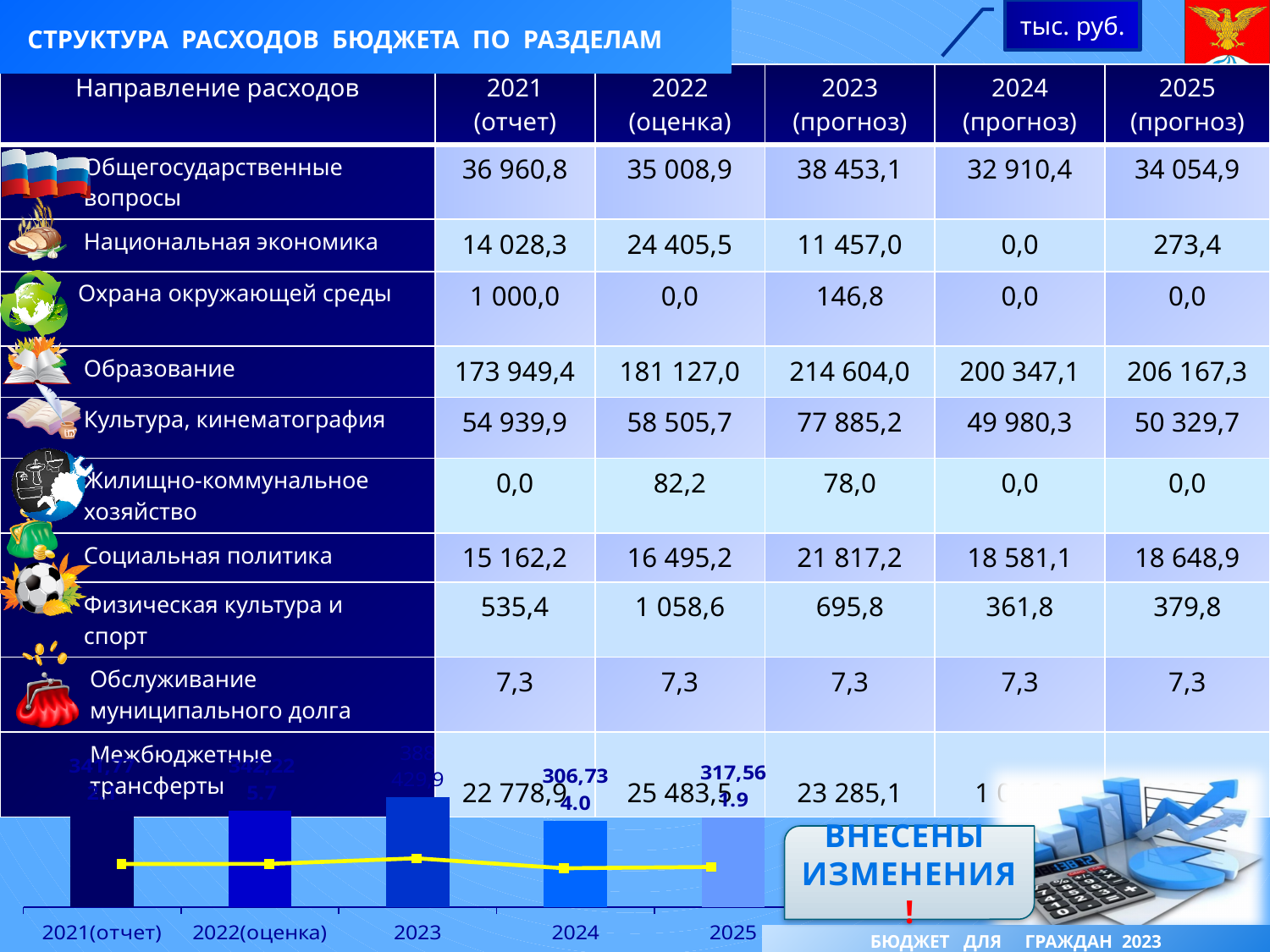
How many categories are shown on the x axis of the chart at the bottom of the slide? 5 In the chart at the bottom of the slide, what is the difference between the bar values for 2025 and 2024? 10,827.9 What is the label of the second category on the x axis of the chart at the bottom of the slide? 2022(оценка) In the chart at the bottom of the slide, do the bar values rise or fall from 2024 to 2025? rise In the chart at the bottom of the slide, do the bar values rise or fall from 2023 to 2024? fall What kind of chart is shown at the bottom of the slide? bar chart with a line overlay In the chart at the bottom of the slide, which bar is taller: 2024 or 2025? 2025 In the chart at the bottom of the slide, what is the bar value labelled for 2024? 306,734.0 What is the label of the first category on the x axis of the chart at the bottom of the slide? 2021(отчет) In the chart at the bottom of the slide, what is the bar value labelled for 2025? 317,561.9